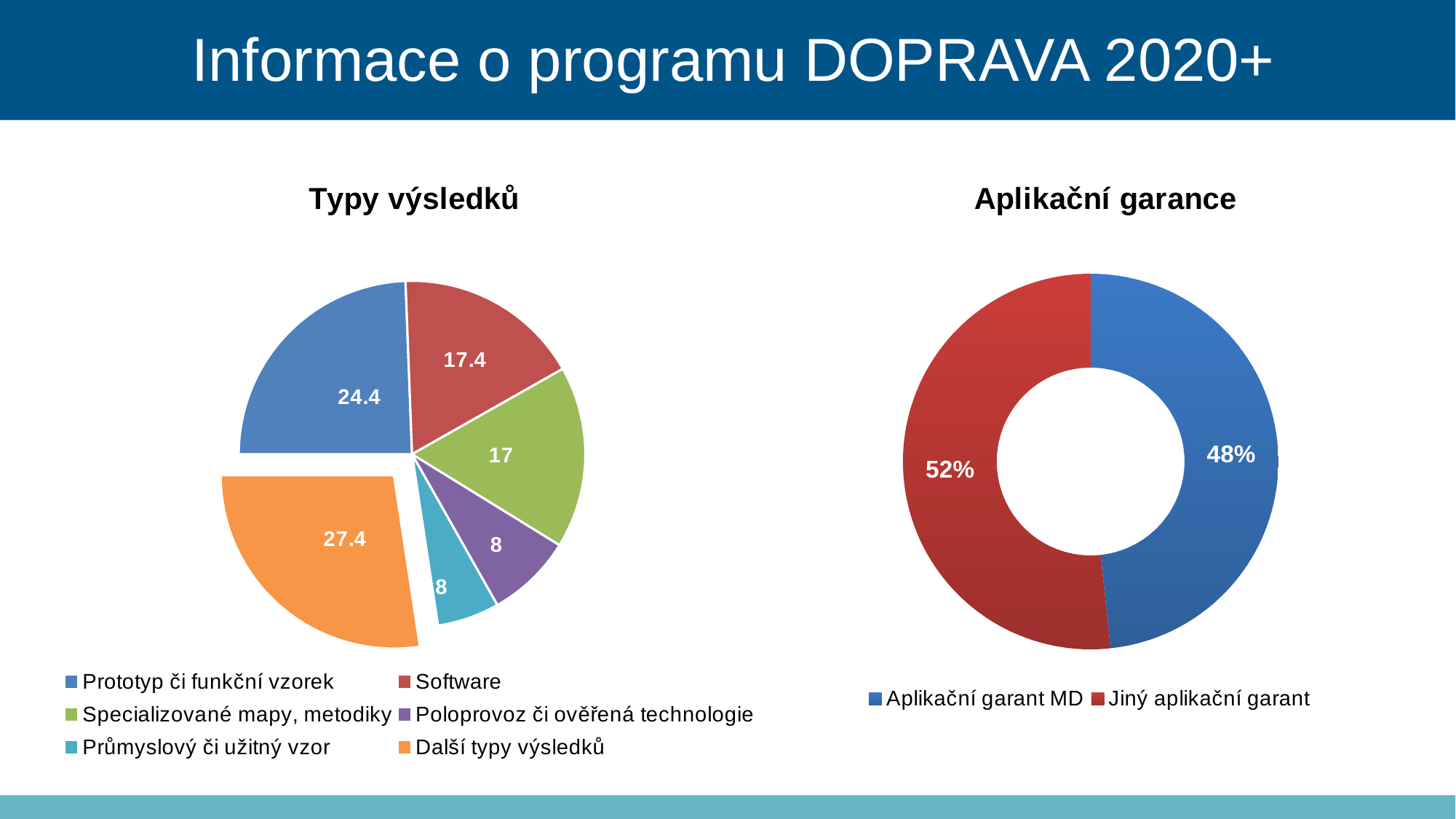
In the "Typy výsledků" chart, what is the difference between Další typy výsledků and Prototyp či funkční vzorek? 3 How many entries does the legend of the "Aplikační garance" chart list? 2 In the "Typy výsledků" chart, which is larger: Software or Poloprovoz či ověřená technologie? Software In the "Typy výsledků" chart, what is the value for Software? 17.4 In the "Typy výsledků" chart, what is the value for Prototyp či funkční vzorek? 24.4 In the "Aplikační garance" chart, what is the share for Aplikační garant MD? 48% In the "Aplikační garance" chart, what is the difference between Jiný aplikační garant and Aplikační garant MD? 4% In the "Typy výsledků" chart, what is the value for Specializované mapy, metodiky? 17 What kind of chart is "Typy výsledků"? Pie chart In the "Typy výsledků" chart, which category has the largest slice? Další typy výsledků In the "Aplikační garance" chart, which category has the larger share? Jiný aplikační garant How many categories does the "Typy výsledků" chart show? 6